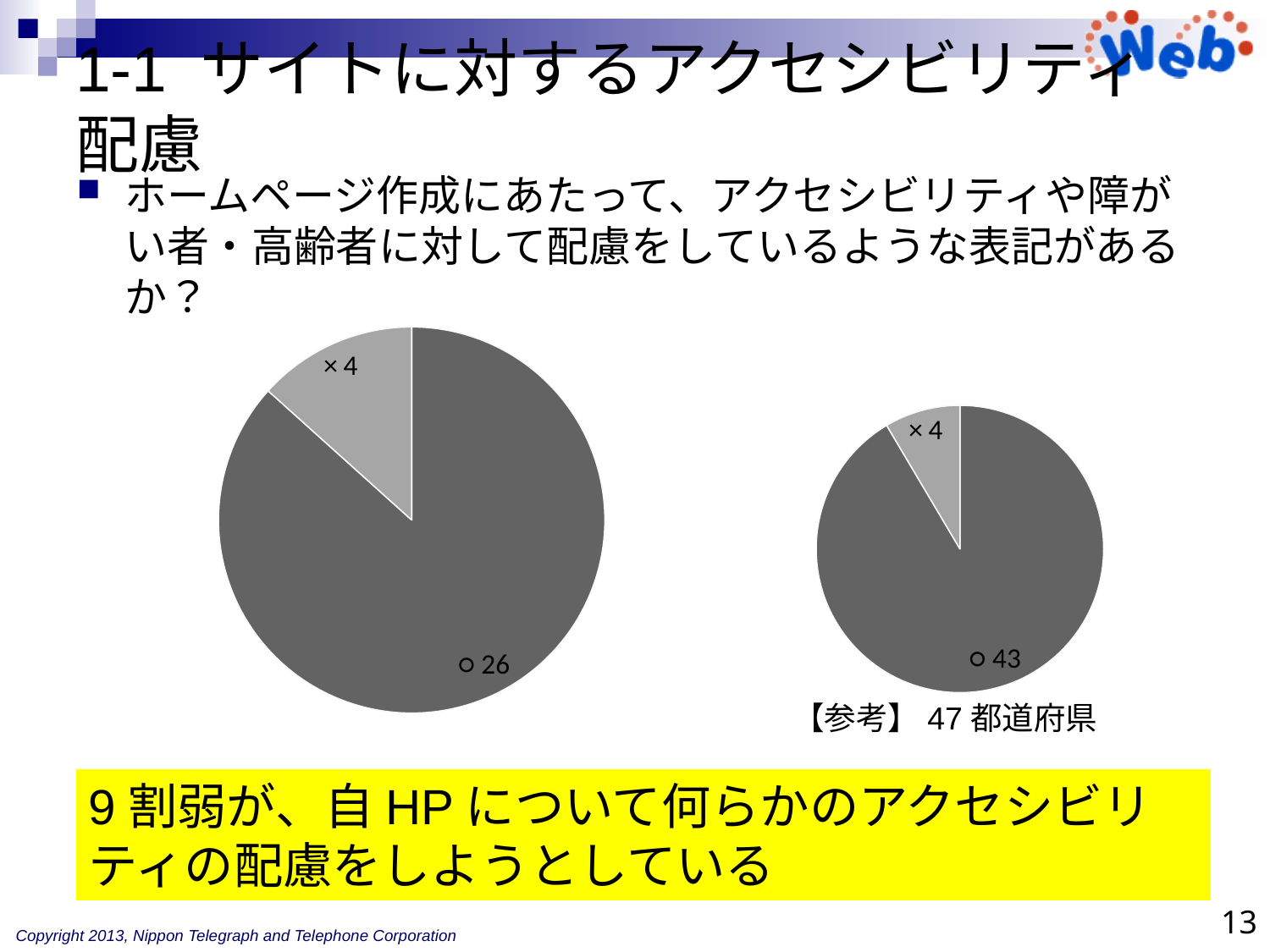
In the left pie chart, which slice is the largest? ○ In the right pie chart (【参考】47都道府県), what is the value for the × slice? 4 How many slices does the left pie chart have? 2 In the left pie chart, what is the value for the ○ slice? 26 In the left pie chart, what fraction of the total does the ○ slice represent? 26 out of 30 What kind of chart is the left chart on the slide? pie chart In the right pie chart (【参考】47都道府県), what is the value for the ○ slice? 43 In the left pie chart, what is the value for the × slice? 4 In the right pie chart (【参考】47都道府県), what is the difference between the ○ value and the × value? 39 In the left pie chart, what is the difference between the ○ value and the × value? 22 In the right pie chart (【参考】47都道府県), which slice is the smallest? × Which is larger: the ○ value in the left pie chart or the ○ value in the right pie chart? the right pie chart (43)